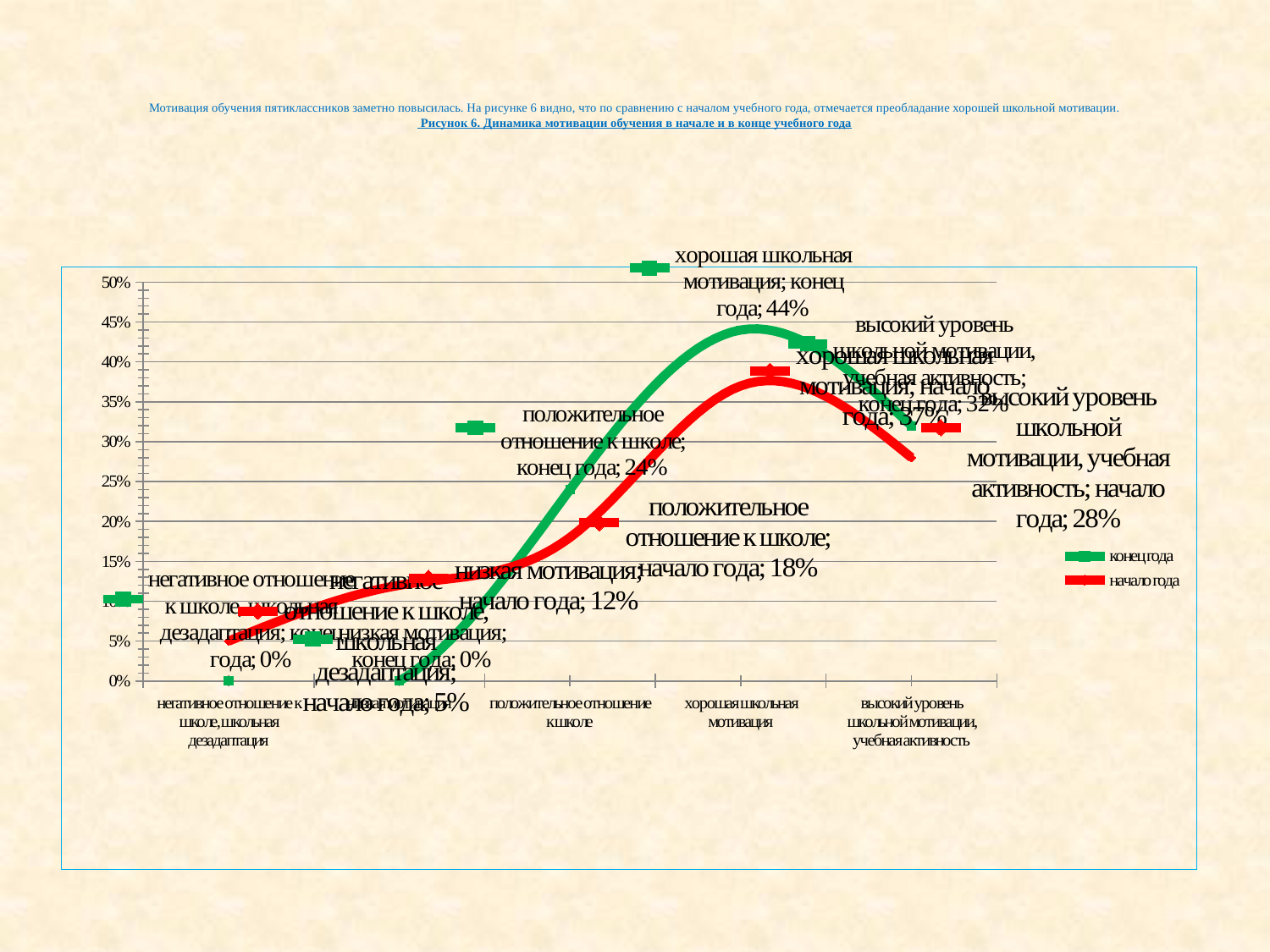
How many categories are shown on the x axis? 5 Which series is drawn in green? конец года What is the value for "положительное отношение к школе" in the "конец года" series? 24% What is the value for "хорошая школьная мотивация" in the "конец года" series? 44% Which category has the highest value in the "конец года" series? хорошая школьная мотивация What kind of chart is shown on the slide? line chart What is the value for "положительное отношение к школе" in the "начало года" series? 18% What is the difference between the "конец года" and "начало года" values for "положительное отношение к школе"? 6% What is the value for "низкая мотивация" in the "начало года" series? 12% For "хорошая школьная мотивация", which series has the larger value, "конец года" or "начало года"? конец года How many series does the legend list? 2 What is the value for "высокий уровень школьной мотивации, учебная активность" in the "начало года" series? 28%